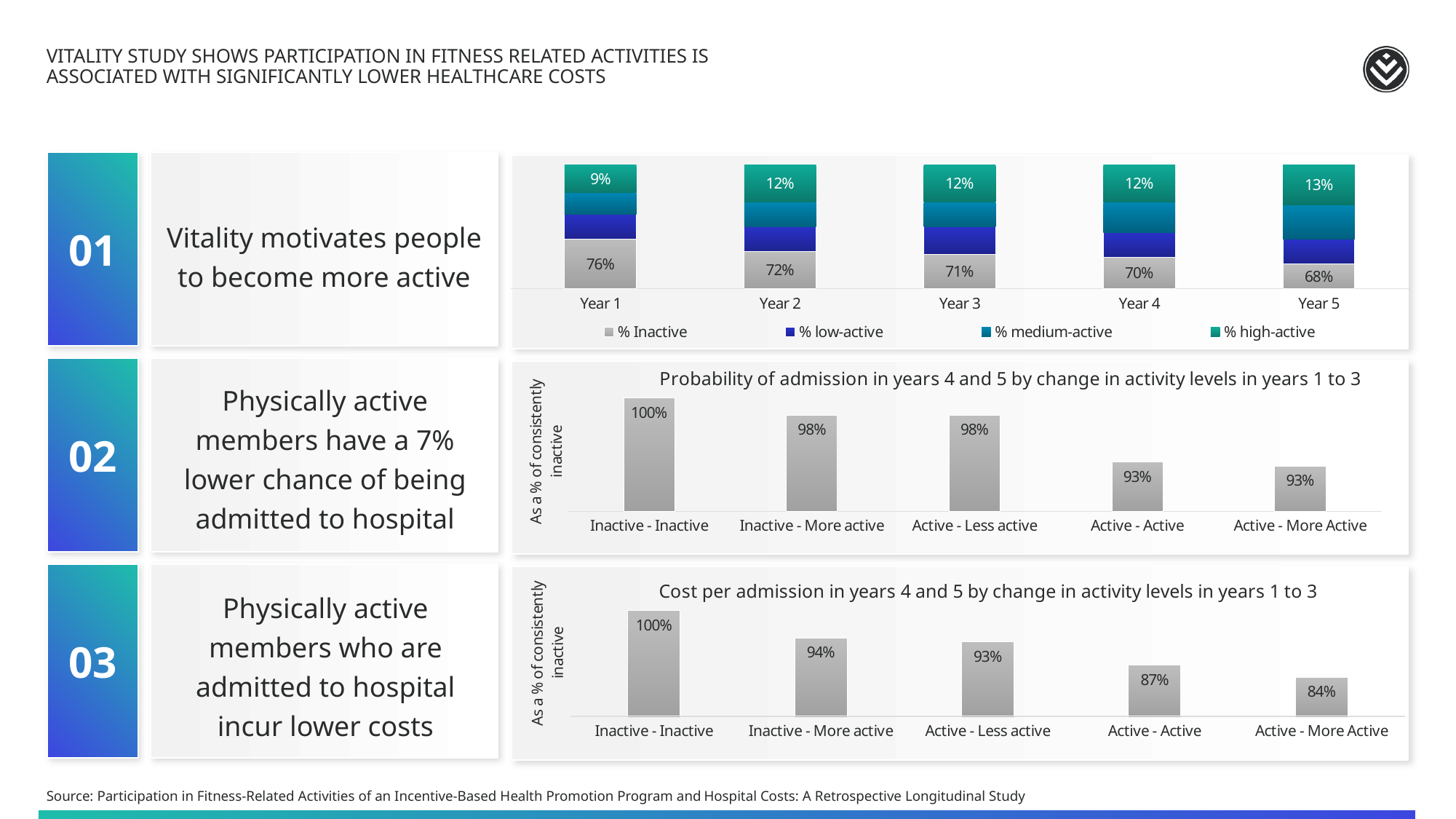
In the chart titled 'Probability of admission in years 4 and 5 by change in activity levels in years 1 to 3', which category has the highest value? Inactive - Inactive What kind of chart is the chart titled 'Cost per admission in years 4 and 5 by change in activity levels in years 1 to 3'? bar chart In the chart titled 'Cost per admission in years 4 and 5 by change in activity levels in years 1 to 3', what is the value for Active - Active? 87% In the top stacked bar chart of activity levels by year, does the % Inactive value rise or fall from Year 1 to Year 5? fall In the top stacked bar chart of activity levels by year, what is the difference between the % Inactive values for Year 1 and Year 5? 8% In the top stacked bar chart of activity levels by year, how many series does the legend list? 4 In the chart titled 'Probability of admission in years 4 and 5 by change in activity levels in years 1 to 3', how many categories are shown? 5 In the chart titled 'Cost per admission in years 4 and 5 by change in activity levels in years 1 to 3', which category has the lowest value? Active - More Active In the top stacked bar chart of activity levels by year, what is the % Inactive value for Year 1? 76% In the chart titled 'Probability of admission in years 4 and 5 by change in activity levels in years 1 to 3', what is the value for Inactive - More active? 98% In the top stacked bar chart of activity levels by year, what is the % high-active value for Year 5? 13% In the chart titled 'Cost per admission in years 4 and 5 by change in activity levels in years 1 to 3', what is the difference between Inactive - Inactive and Active - More Active? 16%